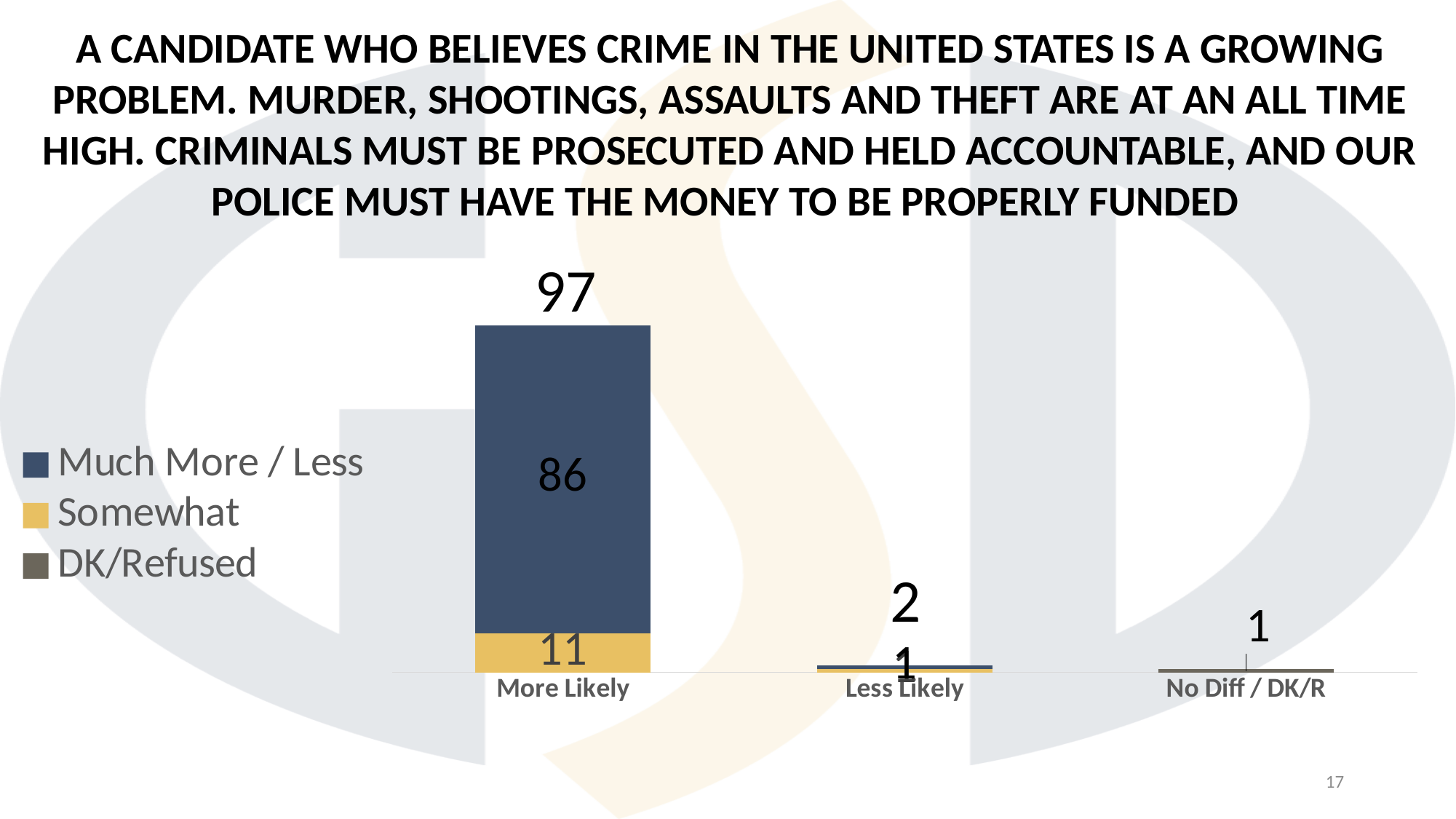
Which category has the lowest total? No Diff / DK/R What is the value of the Much More / Less segment for More Likely? 86 How many series does the legend list? 3 What is the total shown above the More Likely bar? 97 What is the value shown for No Diff / DK/R? 1 What is the value of the Somewhat segment for More Likely? 11 Which category has the highest total? More Likely What is the total shown above the Less Likely bar? 2 What is the difference between the Much More / Less segment and the Somewhat segment for More Likely? 75 How many categories are shown on the x axis? 3 What is the difference between the More Likely total and the Less Likely total? 95 Which is larger, the More Likely total or the Less Likely total? More Likely